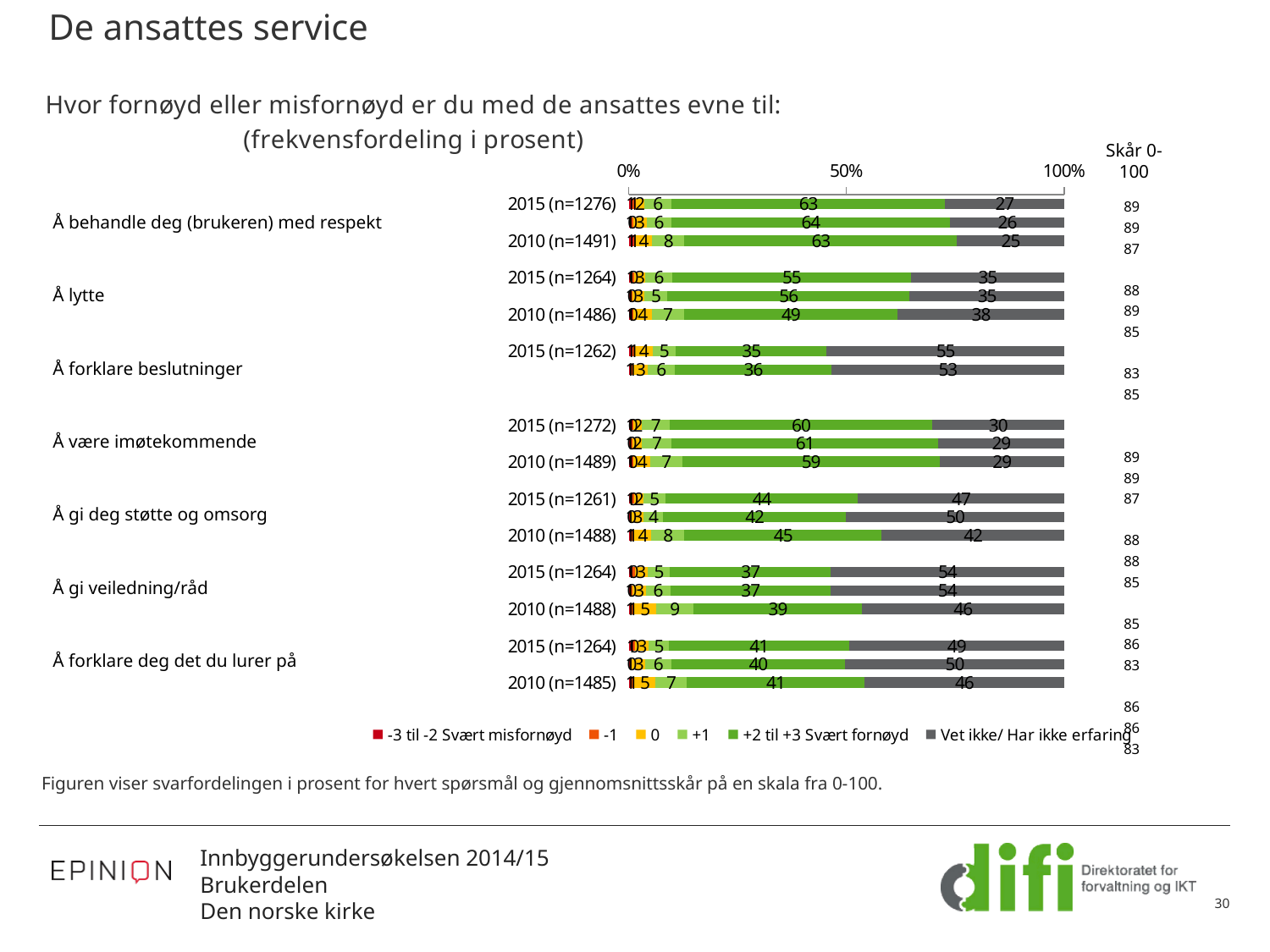
What percentage of respondents in 2015 (n=1276) answered '+2 til +3 Svært fornøyd' for 'Å behandle deg (brukeren) med respekt'? 63 What kind of chart is shown on the slide? Stacked bar chart For 'Å lytte', how many percentage points higher is the '+2 til +3 Svært fornøyd' share in 2015 (n=1264) than in 2010 (n=1486)? 6 How many series does the legend list? 6 What is the 'Vet ikke/ Har ikke erfaring' percentage for 'Å lytte' in 2010 (n=1486)? 38 Among the 2015 bars, which question has the lowest '+2 til +3 Svært fornøyd' percentage? Å forklare beslutninger For 'Å gi deg støtte og omsorg' in 2015 (n=1261), which is larger: the '+2 til +3 Svært fornøyd' share or the 'Vet ikke/ Har ikke erfaring' share? Vet ikke/ Har ikke erfaring What is the 'Vet ikke/ Har ikke erfaring' percentage for 'Å være imøtekommende' in 2015 (n=1272)? 30 What is the '+2 til +3 Svært fornøyd' percentage for 'Å forklare beslutninger' in 2015 (n=1262)? 35 Among the 2015 bars, which question has the highest '+2 til +3 Svært fornøyd' percentage? Å behandle deg (brukeren) med respekt Which legend entry is shown in dark grey? Vet ikke/ Har ikke erfaring What is the '+1' percentage for 'Å gi veiledning/råd' in 2010 (n=1488)? 9